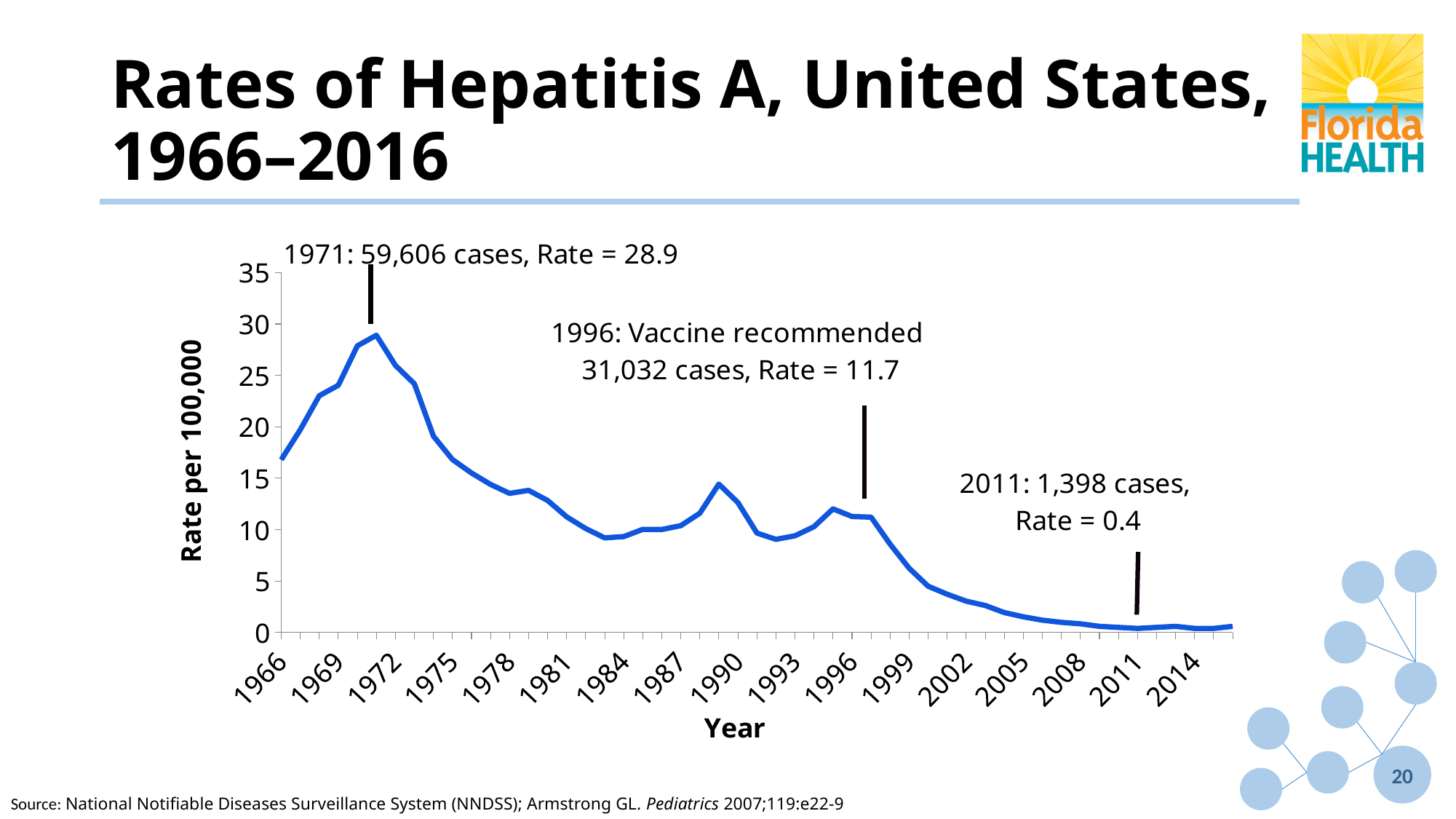
What kind of chart is shown on the slide? line chart What is the difference between the rate in 1996 and the rate in 2011? 11.3 In which year does the rate of Hepatitis A reach its highest point? 1971 Is the rate for 1966 greater or less than 15? greater What was the rate of Hepatitis A in 1996, when the vaccine was recommended? 11.7 Which year had a higher rate, 1971 or 1996? 1971 What is the difference between the rate in 1971 and the rate in 1996? 17.2 Overall, does the rate of Hepatitis A rise or fall from 1971 to 2016? fall How many cases of Hepatitis A were reported in 1971? 59,606 What was the rate of Hepatitis A in 2011? 0.4 How many cases were reported in 2011? 1,398 What was the rate of Hepatitis A in 1971? 28.9